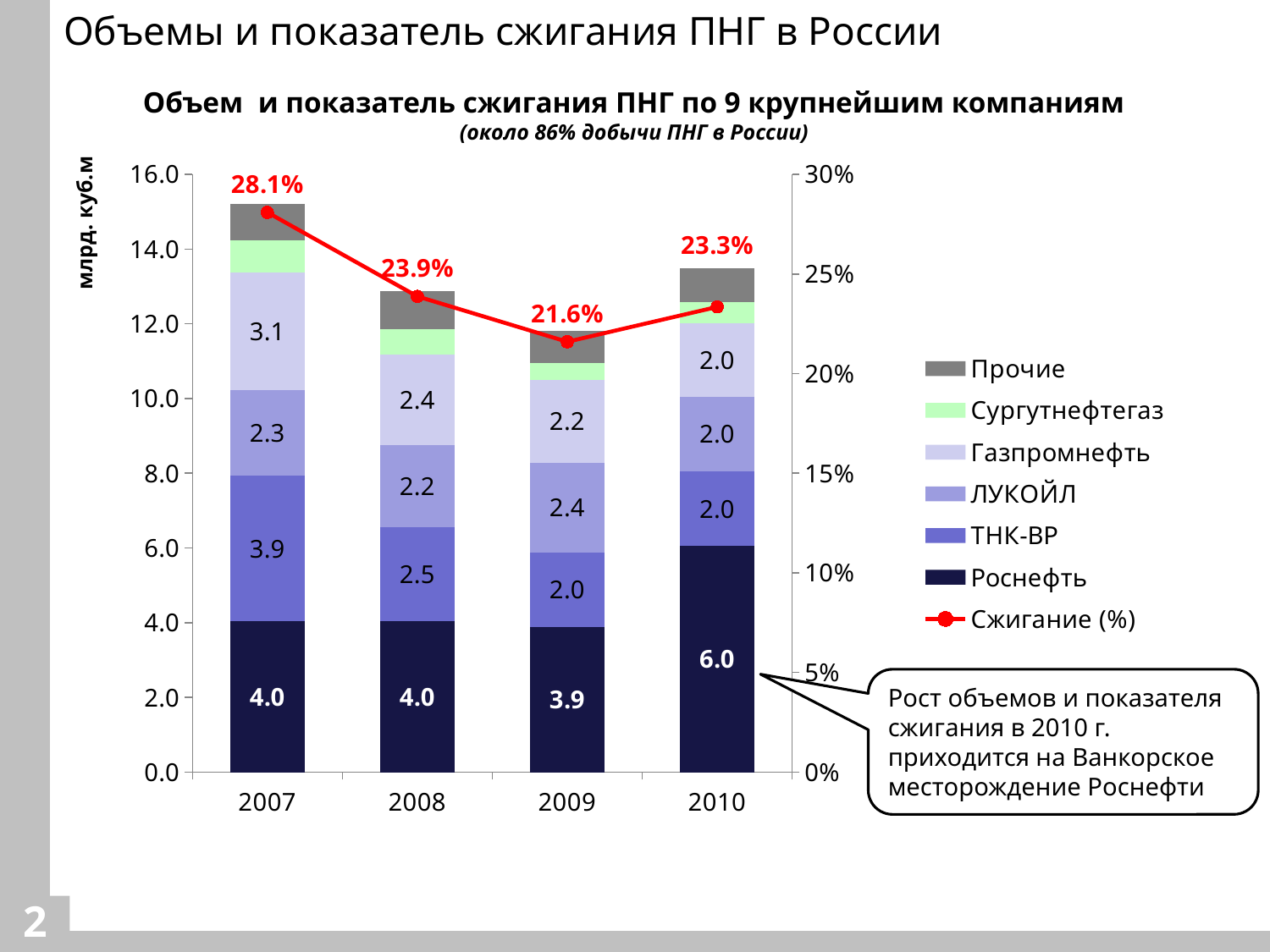
How many years are shown on the x axis? 4 What is the value for ЛУКОЙЛ in 2009? 2.4 How many series does the legend list? 7 Which year has the larger ТНК-ВР value, 2007 or 2008? 2007 Is the total height of the 2007 stacked bar greater or less than 14.0? greater What kind of chart is shown on the slide? Stacked bar chart with a line series In which year is the Сжигание (%) value lowest? 2009 What is the difference between the Сжигание (%) values for 2007 and 2008? 4.2 percentage points By how much did the Роснефть value increase from 2009 to 2010? 2.1 What is the Сжигание (%) value for 2007? 28.1% In which year is the Сжигание (%) value highest? 2007 What is the value for Роснефть in 2010? 6.0